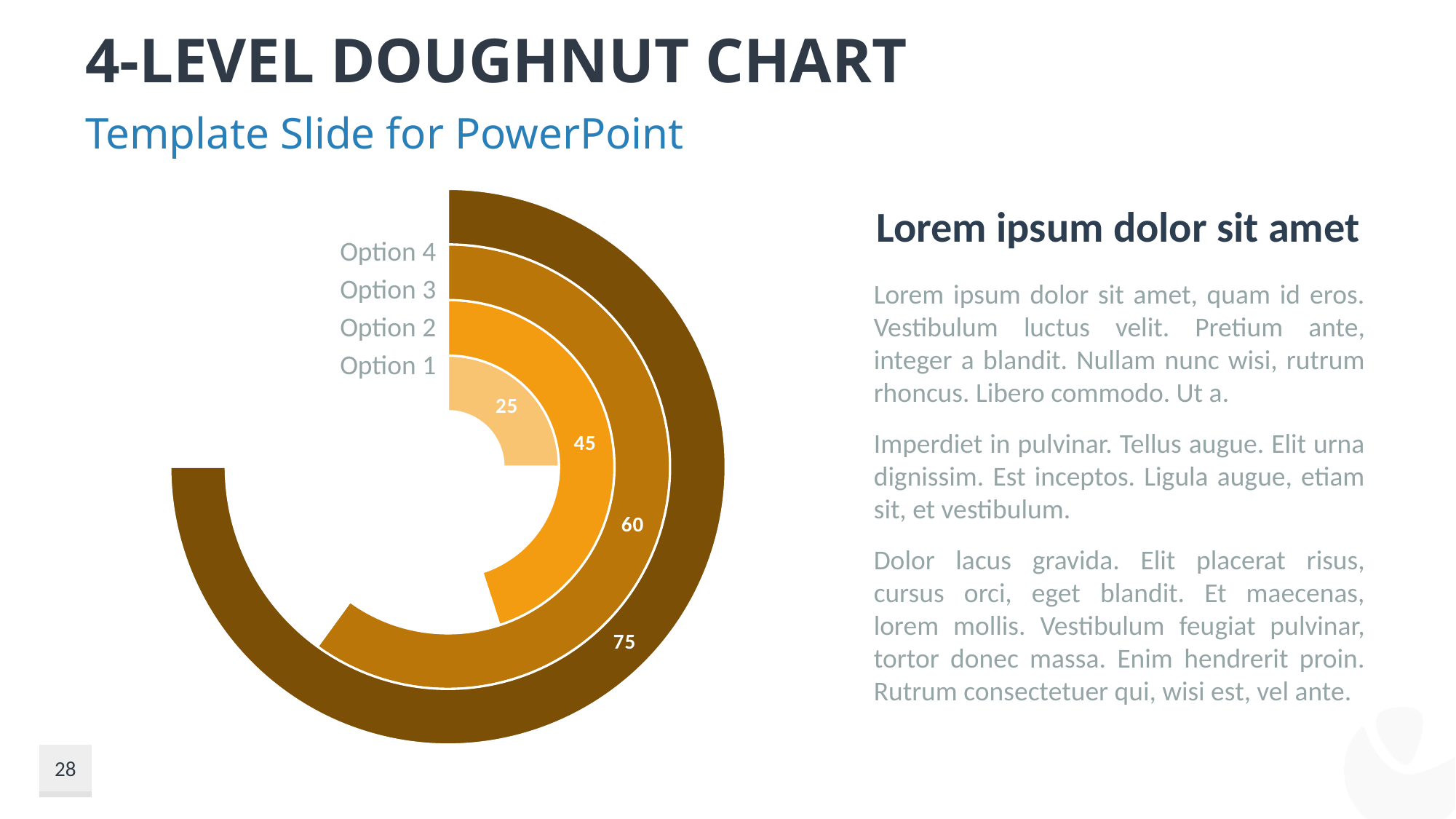
What is the difference between the values for Option 4 and Option 1? 50 Which has a larger value, Option 2 or Option 3? Option 3 What value is shown for Option 4? 75 What value is shown for Option 2? 45 What value is shown for Option 3? 60 Which option has the highest value? Option 4 What is the difference between the values for Option 3 and Option 2? 15 What kind of chart is shown on the slide? Doughnut chart How many options (levels) does the doughnut chart show? 4 Do the values increase or decrease from Option 1 to Option 4? Increase What value is shown for Option 1? 25 Which option has the lowest value? Option 1